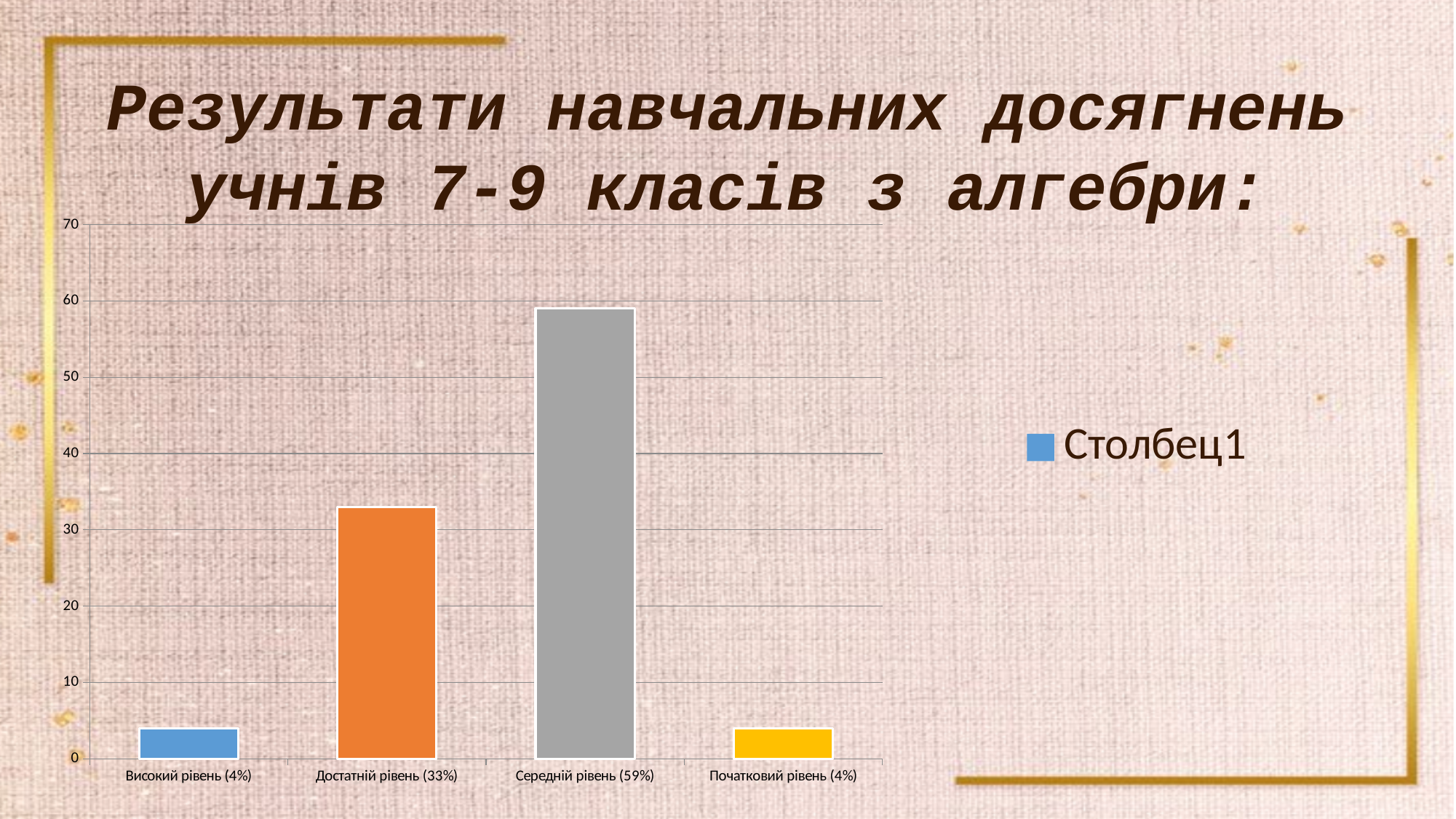
What percentage is shown for Достатній рівень? 33% How many categories are shown on the x axis of the chart? 4 What is the difference between the percentages for Середній рівень and Достатній рівень? 26% Which is larger, the value for Достатній рівень or the value for Середній рівень? Середній рівень What percentage is shown for Середній рівень? 59% Is the value for Достатній рівень greater or less than 30? greater How many series does the chart legend list? 1 Which category has the highest bar in the chart? Середній рівень (59%) What kind of chart is shown on the slide? bar chart What percentage is shown for Початковий рівень? 4% Is the value for Високий рівень greater or less than 10? less What is the name of the series shown in the chart legend? Столбец1